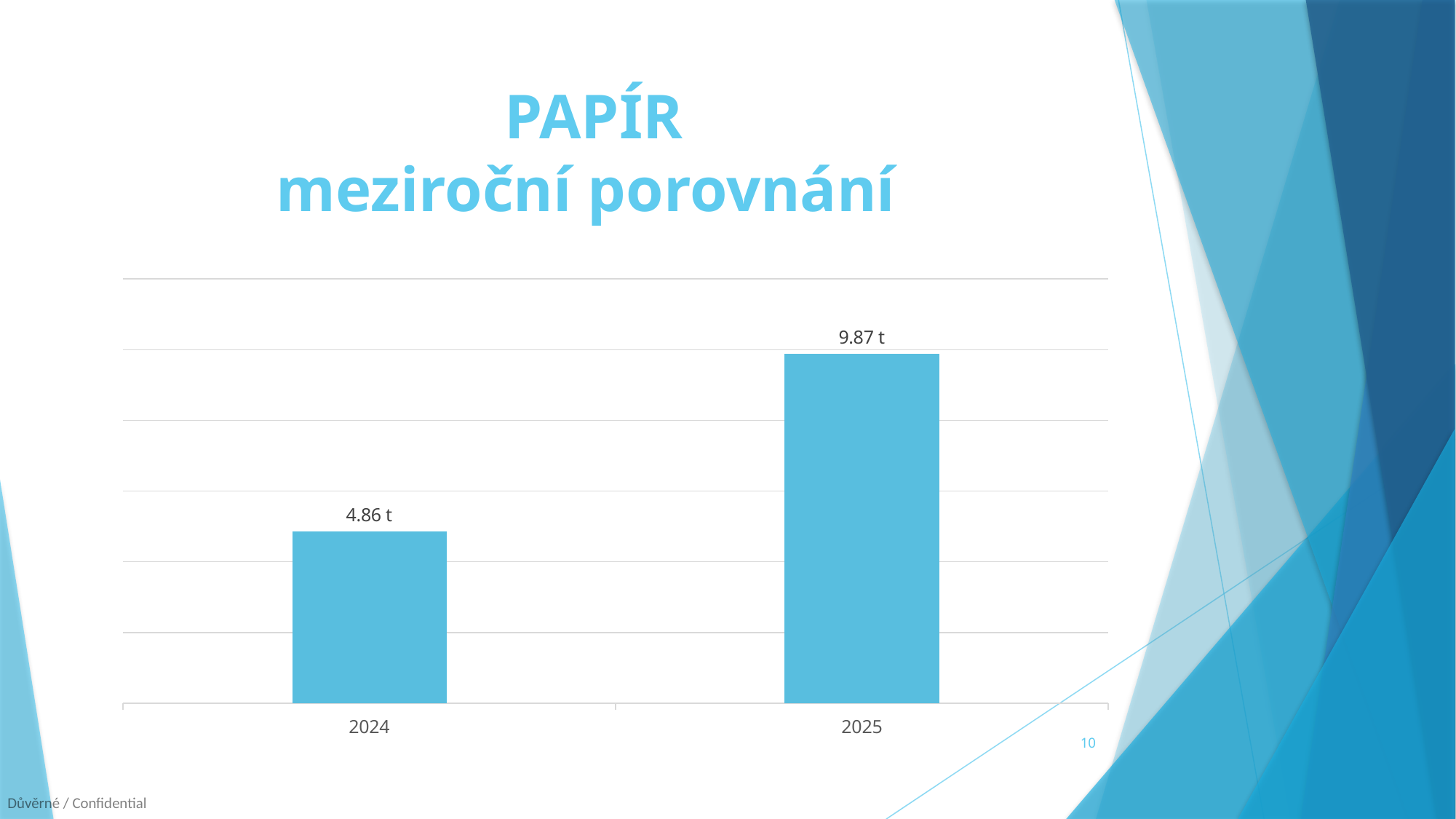
What is the title of the slide containing the chart? PAPÍR meziroční porovnání What colour are the bars in the chart? light blue Which is larger, the value for 2024 or the value for 2025? 2025 Which year has the highest value? 2025 Do the values rise or fall from 2024 to 2025? rise What is the value for 2024? 4.86 t Which year has the lowest value? 2024 What is the difference between the values for 2025 and 2024? 5.01 t What is the value for 2025? 9.87 t How many categories are shown on the x axis? 2 What kind of chart is shown on the slide? bar chart